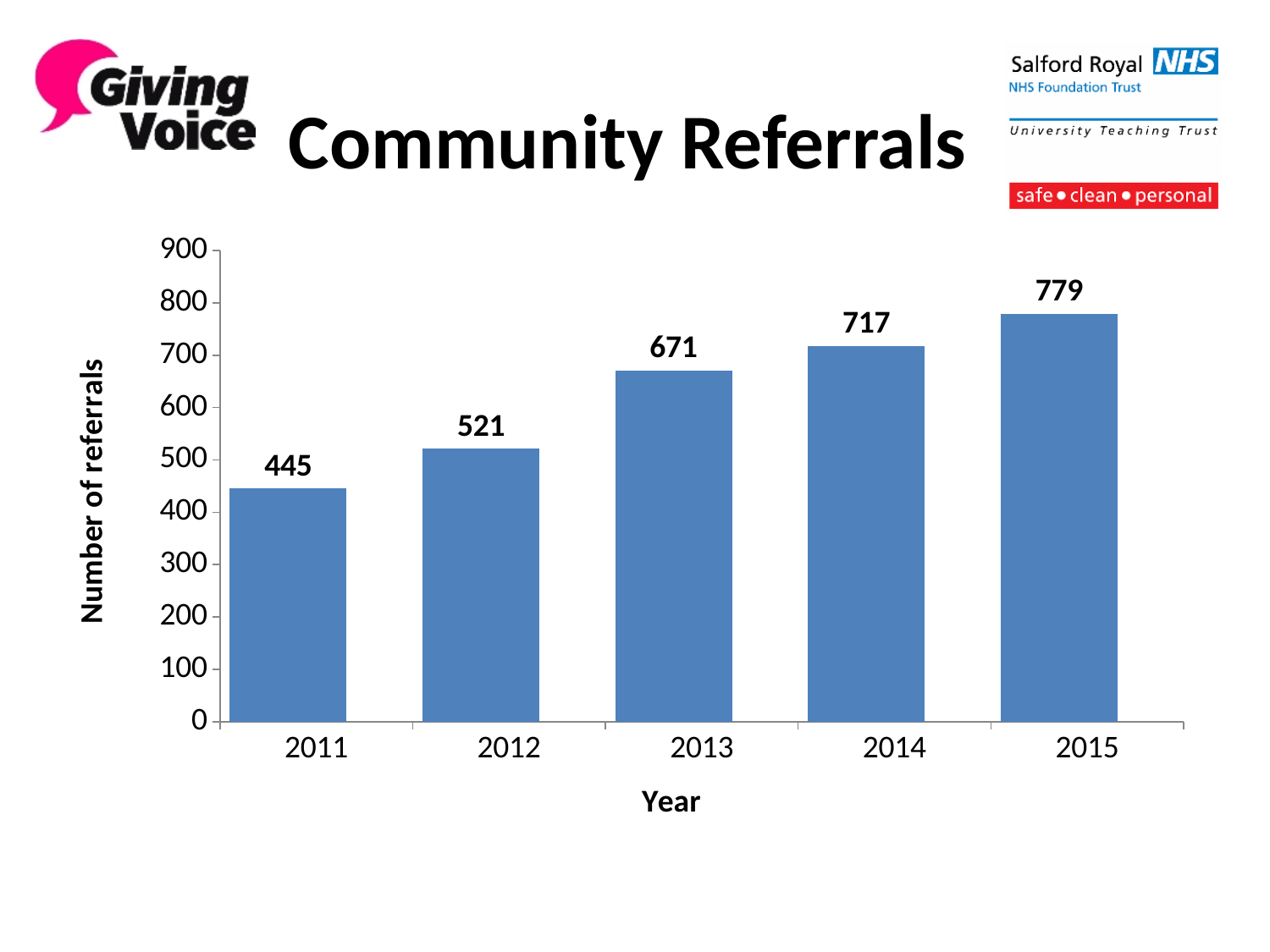
Is the value for 2012 greater or less than 500? greater Do the number of referrals rise or fall from 2011 to 2015? Rise What is the number of community referrals in 2011? 445 What is the number of community referrals in 2015? 779 Which year has the highest number of referrals? 2015 What is the difference in referrals between 2014 and 2013? 46 Which year has the lowest number of referrals? 2011 What is the difference in referrals between 2015 and 2011? 334 Which year had more referrals, 2012 or 2014? 2014 How many years are shown on the chart? 5 What is the number of community referrals in 2013? 671 What kind of chart is shown on the slide? Bar chart